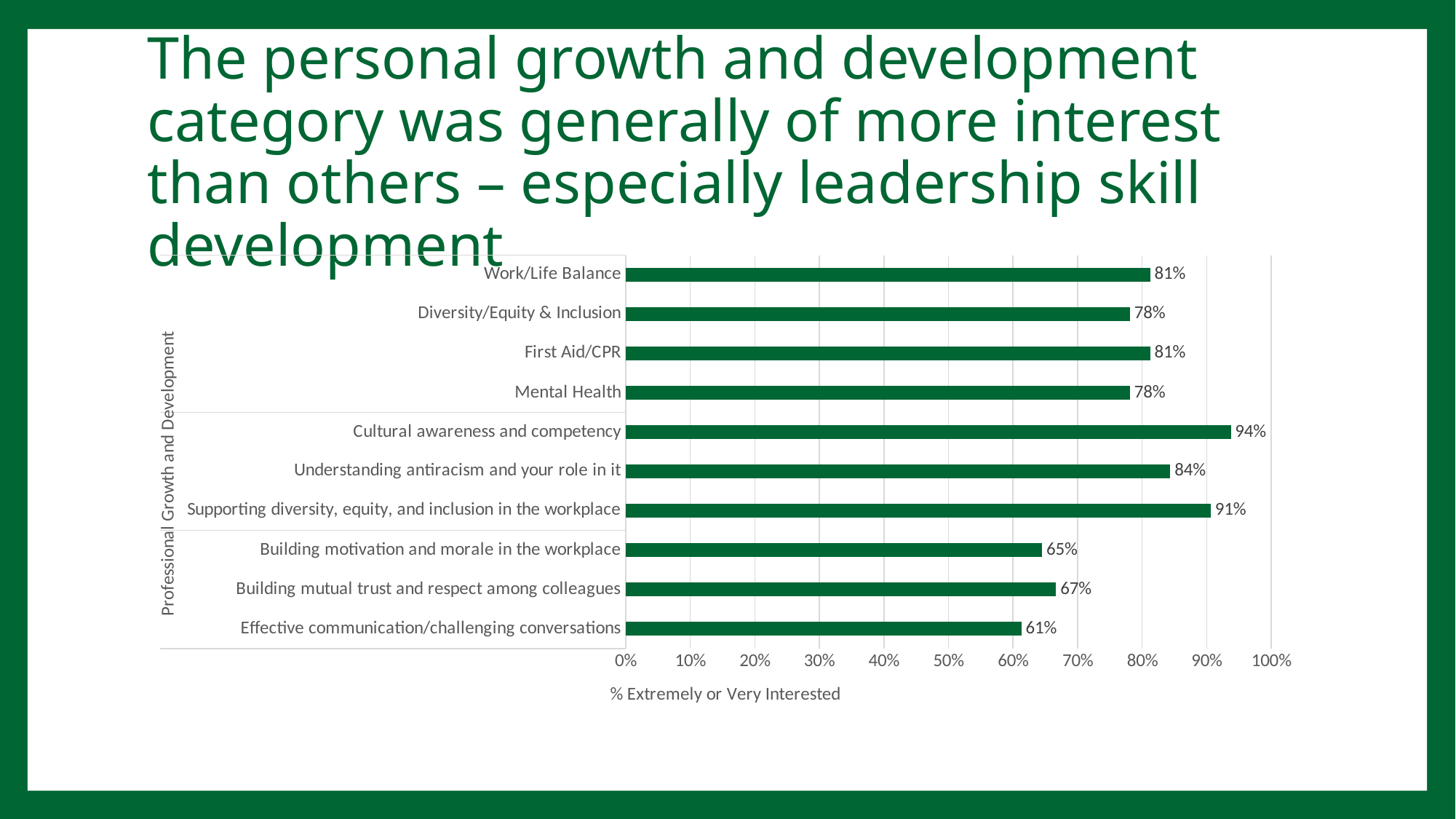
What is the label of the horizontal axis? % Extremely or Very Interested Which category has the highest value? Cultural awareness and competency What is the value for Cultural awareness and competency? 94% Which category has the lowest value? Effective communication/challenging conversations What is the value for Building mutual trust and respect among colleagues? 67% Which is larger, the value for Work/Life Balance or the value for Building motivation and morale in the workplace? Work/Life Balance What kind of chart is shown on the slide? Bar chart What is the value for Effective communication/challenging conversations? 61% How many categories are shown in the chart? 10 What is the difference between the values for Cultural awareness and competency and Effective communication/challenging conversations? 33% What is the value for Understanding antiracism and your role in it? 84% What is the difference between the values for Supporting diversity, equity, and inclusion in the workplace and Building motivation and morale in the workplace? 26%